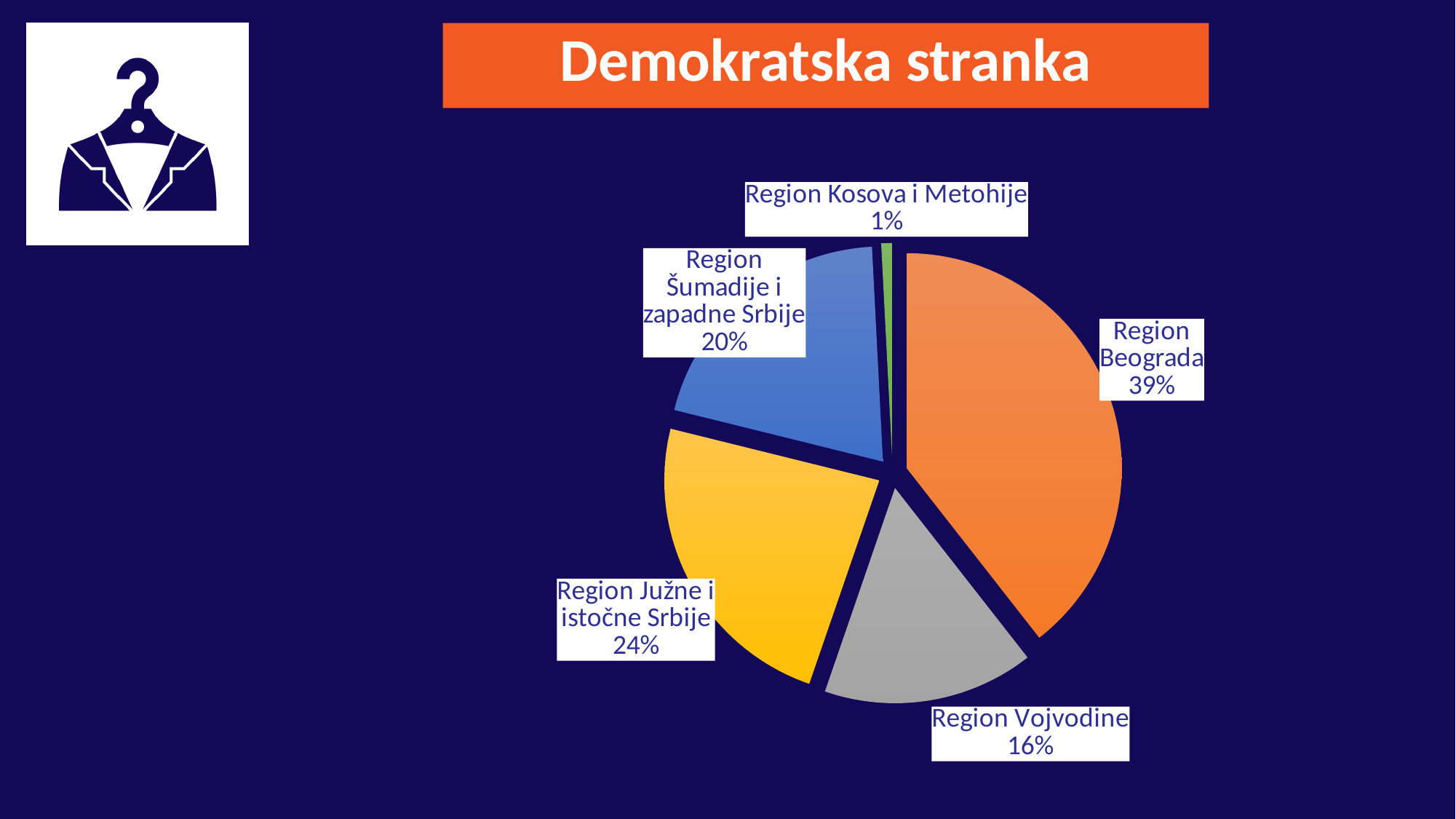
What percentage is labelled for Region Šumadije i zapadne Srbije? 20% What is the difference in percentage points between Region Beograda and Region Vojvodine? 23 What percentage is shown for Region Vojvodine? 16% Which is larger, Region Južne i istočne Srbije or Region Šumadije i zapadne Srbije? Region Južne i istočne Srbije What share does Region Kosova i Metohije have? 1% What is the value for Region Južne i istočne Srbije? 24% Which region has the smallest slice of the pie? Region Kosova i Metohije What type of chart is shown on the slide? Pie chart What share of the pie does Region Beograda hold? 39% What is the title shown above the chart? Demokratska stranka How many regions are shown in the pie chart? 5 Which region has the largest slice of the pie? Region Beograda